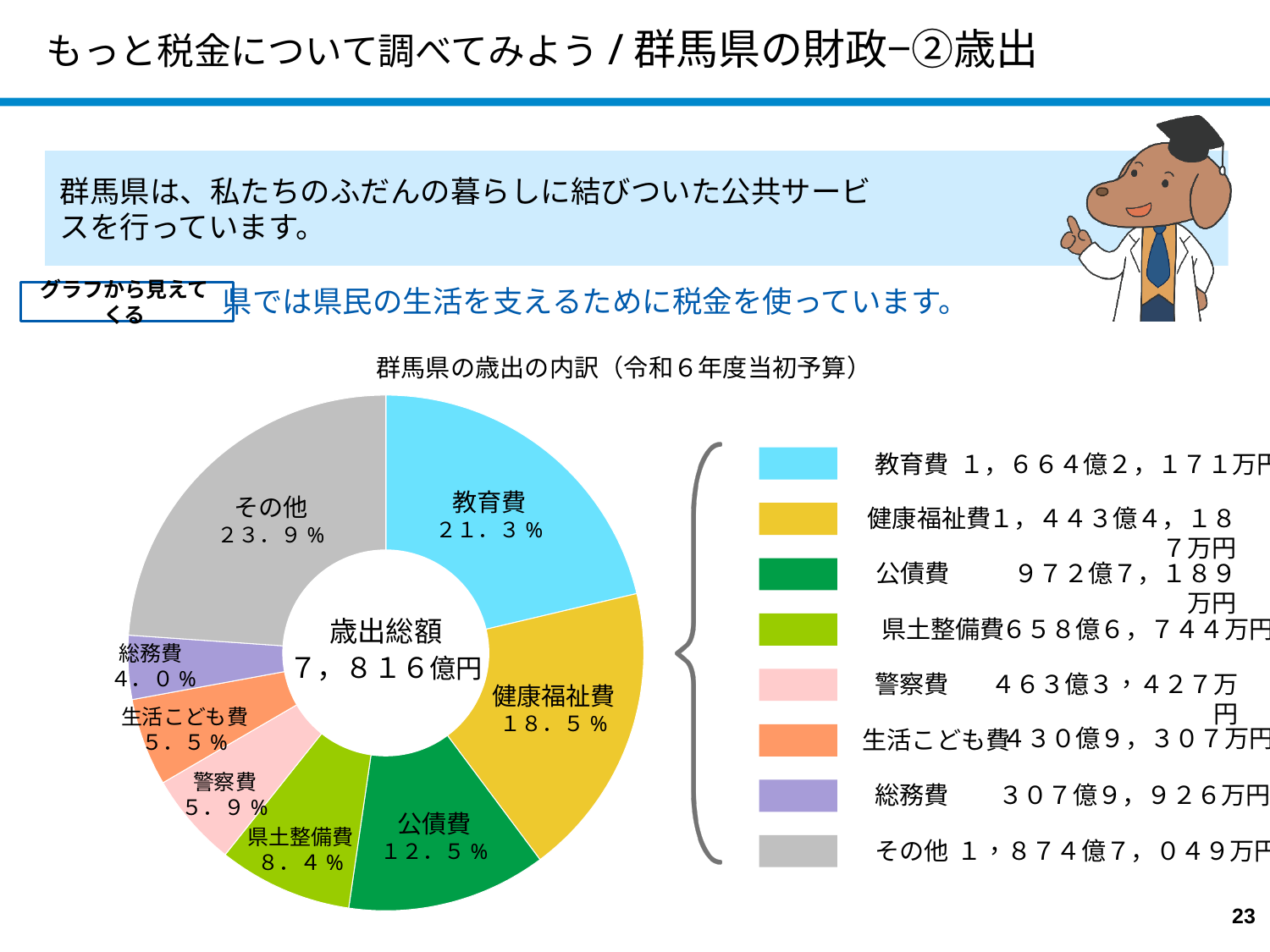
What kind of chart is shown on the slide? pie chart (donut) What is the difference in percentage points between 教育費 and 健康福祉費? 2.8 percentage points Which category has the smallest share in the chart? 総務費 (4.0%) According to the legend, what is the amount for 公債費? 972億7,189万円 What percentage share does 健康福祉費 have in the chart? 18.5% Which has the larger share, 警察費 or 生活こども費? 警察費 What percentage share does 教育費 have in the chart? 21.3% What is the difference in percentage points between 公債費 and 県土整備費? 4.1 percentage points Which category has the largest share in the chart? その他 (23.9%) What is the title of the chart? 群馬県の歳出の内訳（令和６年度当初予算） What is the 歳出総額 shown in the centre of the chart? 7,816億円 How many categories are shown in the chart? 8